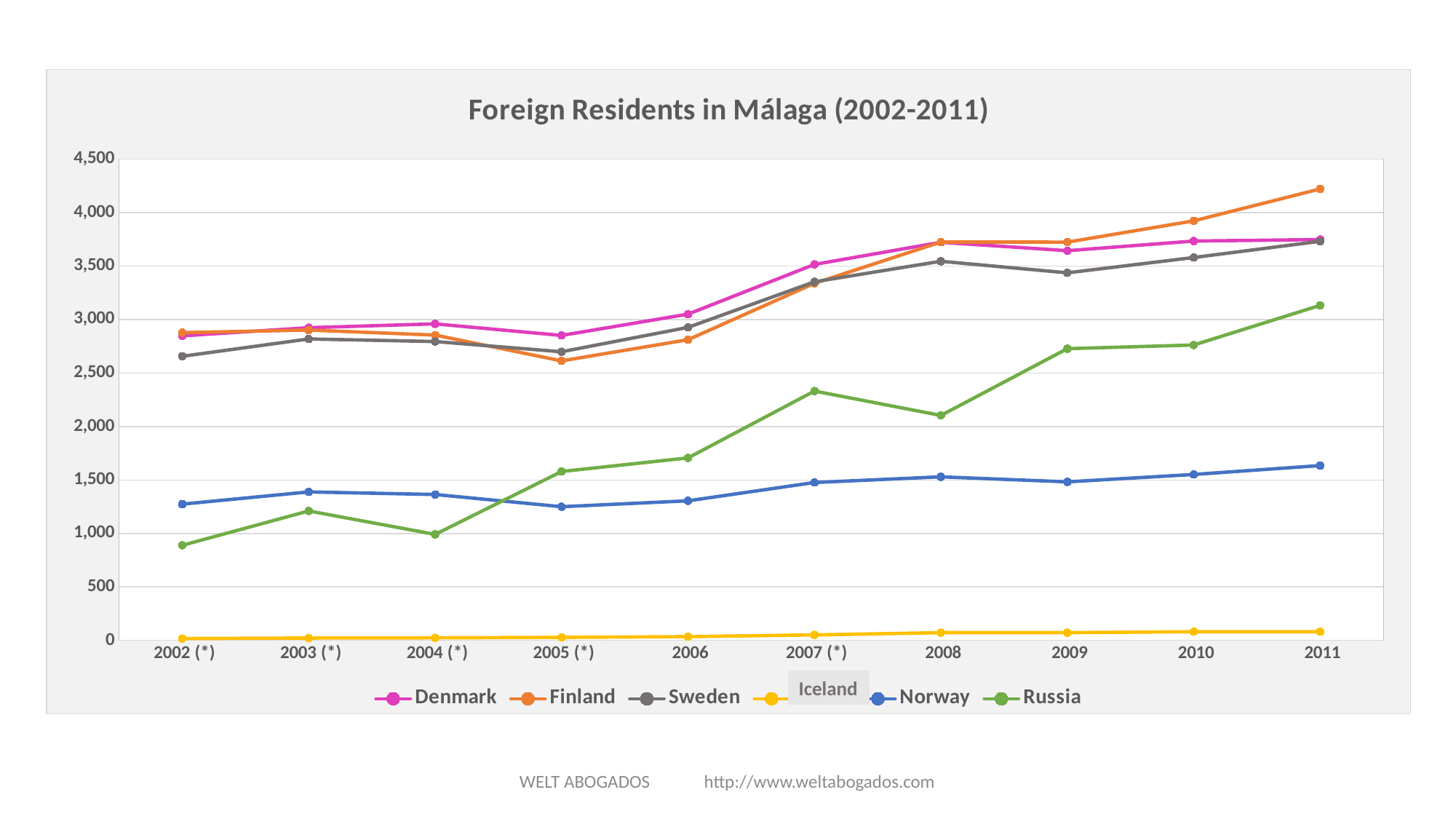
Does the value for Russia rise or fall overall from 2005 (*) to 2011? rise Which is larger in 2002 (*), the value for Norway or the value for Russia? Norway Which country has the lowest number of foreign residents across all years? Iceland What is the title of the chart? Foreign Residents in Málaga (2002-2011) In which year does Finland reach its lowest value? 2005 (*) Which is larger in 2011, the value for Russia or the value for Norway? Russia How many years are plotted along the x axis? 10 How many series does the legend list? 6 Is the value for Finland in 2011 greater or less than 4,000? greater What kind of chart is shown on the slide? line chart Is the value for Russia in 2002 (*) greater or less than 1,000? less Which country has the highest number of foreign residents in 2011? Finland